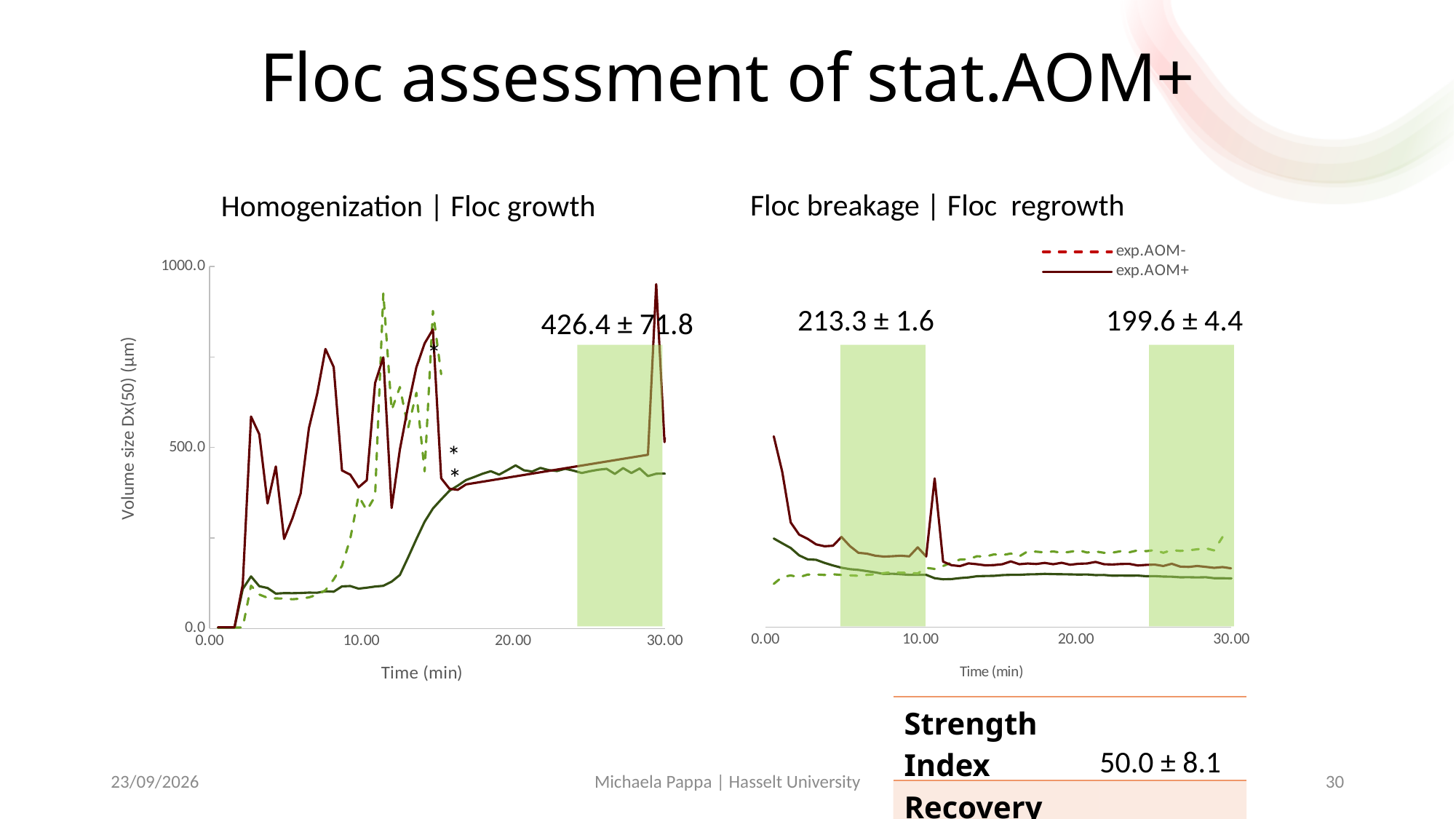
On the left 'Homogenization | Floc growth' chart, what value is annotated above the shaded region near 25–30 min? 426.4 ± 71.8 On the right 'Floc breakage | Floc regrowth' chart, what value is annotated above the first shaded region (around 5–10 min)? 213.3 ± 1.6 What is the maximum value shown on the y-axis of the left 'Homogenization | Floc growth' chart? 1000.0 On the right 'Floc breakage | Floc regrowth' chart, what value is annotated above the second shaded region (around 25–30 min)? 199.6 ± 4.4 What kind of chart is the 'Homogenization | Floc growth' chart on the left? line chart What is the x-axis label of the right 'Floc breakage | Floc regrowth' chart? Time (min) How many series does the legend on the right chart list? 2 What kind of chart is the 'Floc breakage | Floc regrowth' chart on the right? line chart What Strength Index value is reported in the table below the right chart? 50.0 ± 8.1 What is the y-axis label of the left 'Homogenization | Floc growth' chart? Volume size Dx(50) (µm) On the left 'Homogenization | Floc growth' chart, is the value of the solid exp.AOM+ line at 10.00 min greater or less than 500? less